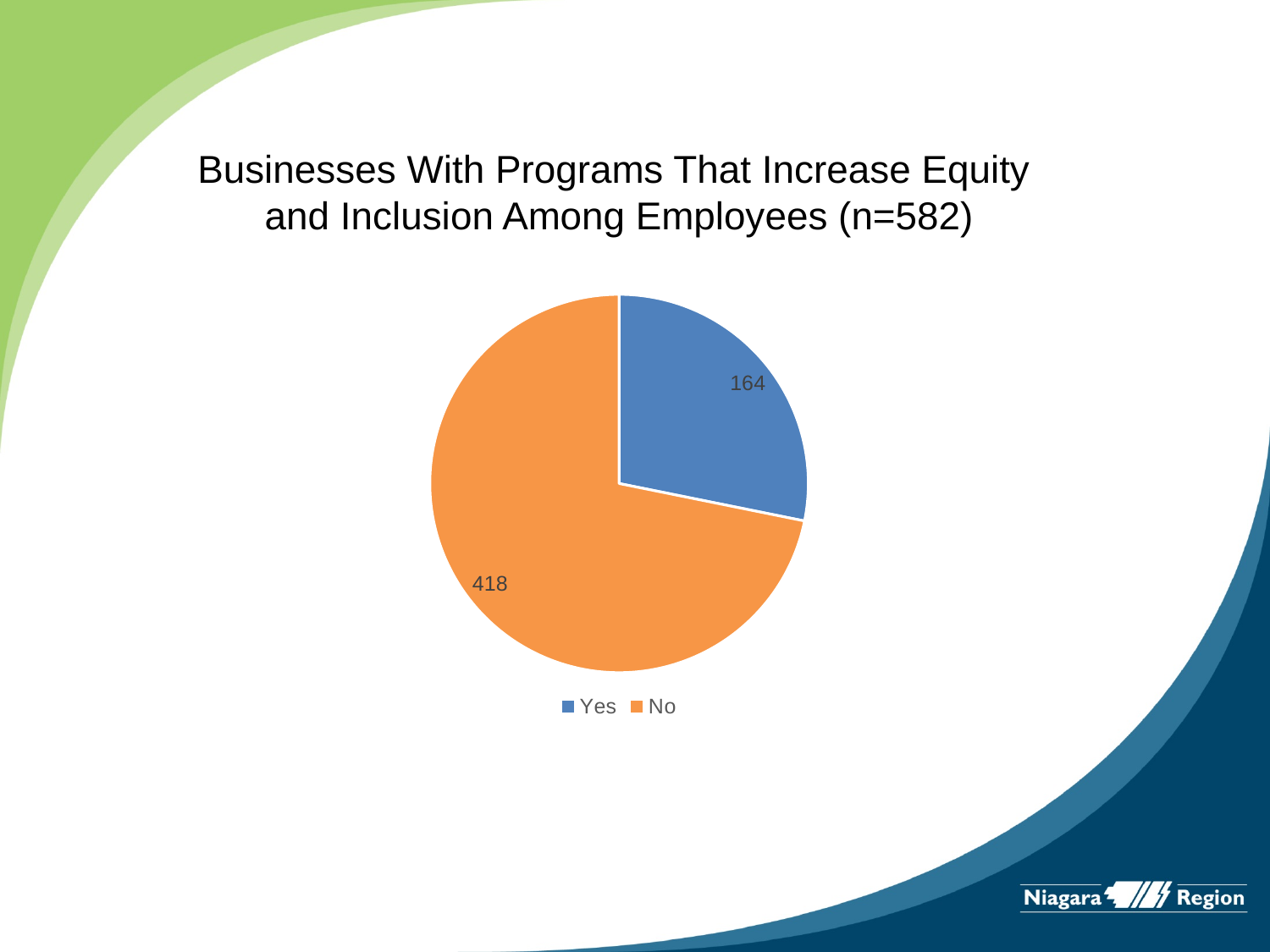
How many businesses answered Yes? 164 Which category has the largest slice of the pie? No What is the title of the chart? Businesses With Programs That Increase Equity and Inclusion Among Employees (n=582) What is the difference between the number of No responses and Yes responses? 254 What colour is the Yes slice? blue How many slices does the pie chart have? 2 Which category has the smallest slice of the pie? Yes What type of chart is shown on the slide? pie chart What is the total of the two slices in the pie chart? 582 How many businesses answered No? 418 Which response has the larger slice, Yes or No? No How many entries does the legend list? 2